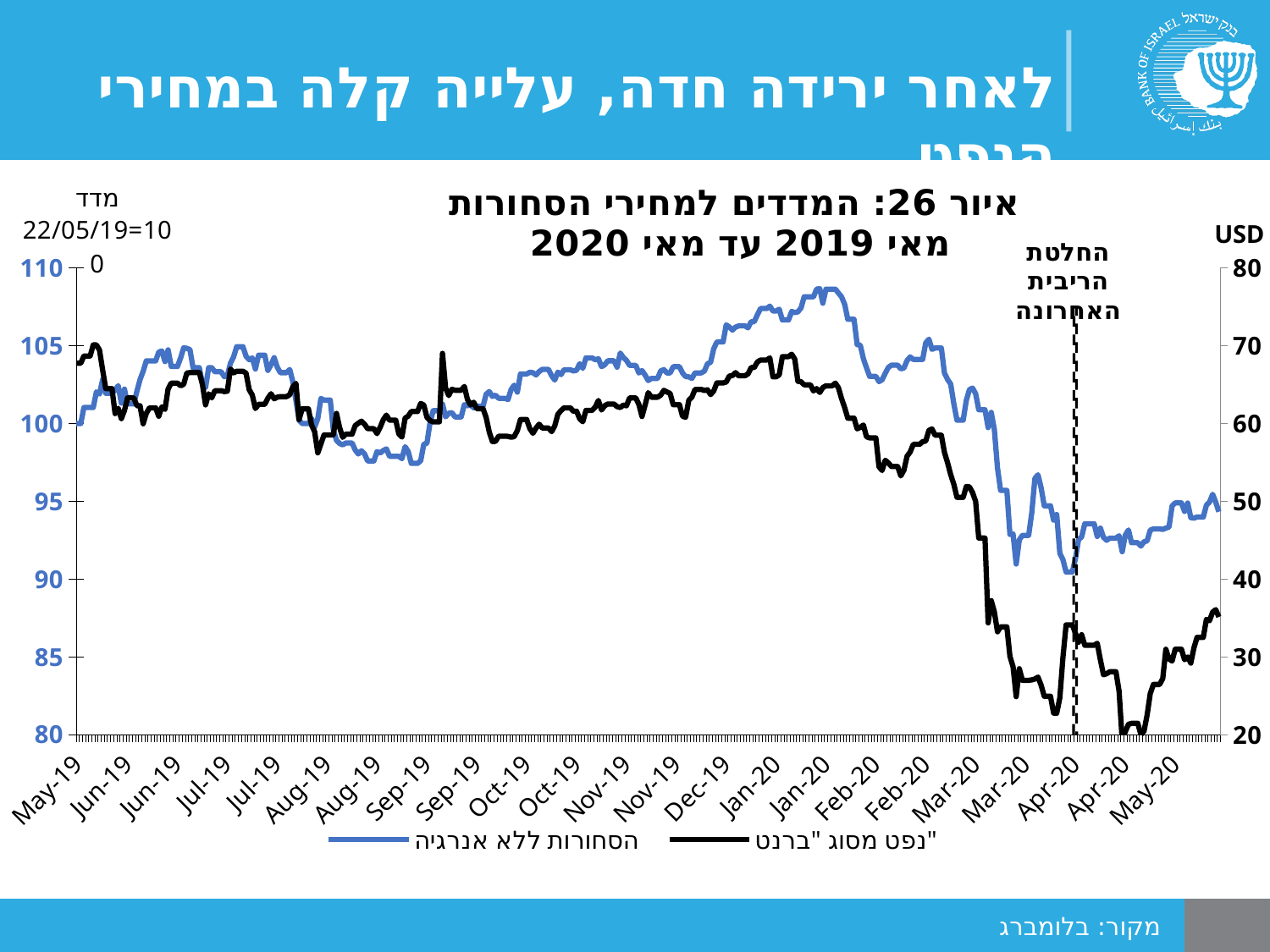
Is the value of the non-energy commodities series (blue line) in early September 2019 greater or less than 100? less Is the value of the non-energy commodities series (blue line) in early April 2020 greater or less than 95? less Does the non-energy commodities series (blue line) rise or fall between January 2020 and April 2020? fall What is the title of the chart? איור 26: המדדים למחירי הסחורות מאי 2019 עד מאי 2020 Which series is drawn in black according to the legend? נפט מסוג "ברנט" Is the value of the Brent oil series (black line) at the end of April 2020 greater or less than 30 USD? less How many series does the legend list? 2 What is the unit shown on the right-hand axis of the chart? USD Does the Brent oil series (black line) rise or fall between late April 2020 and May 2020? rise What kind of chart is shown on the slide? line chart